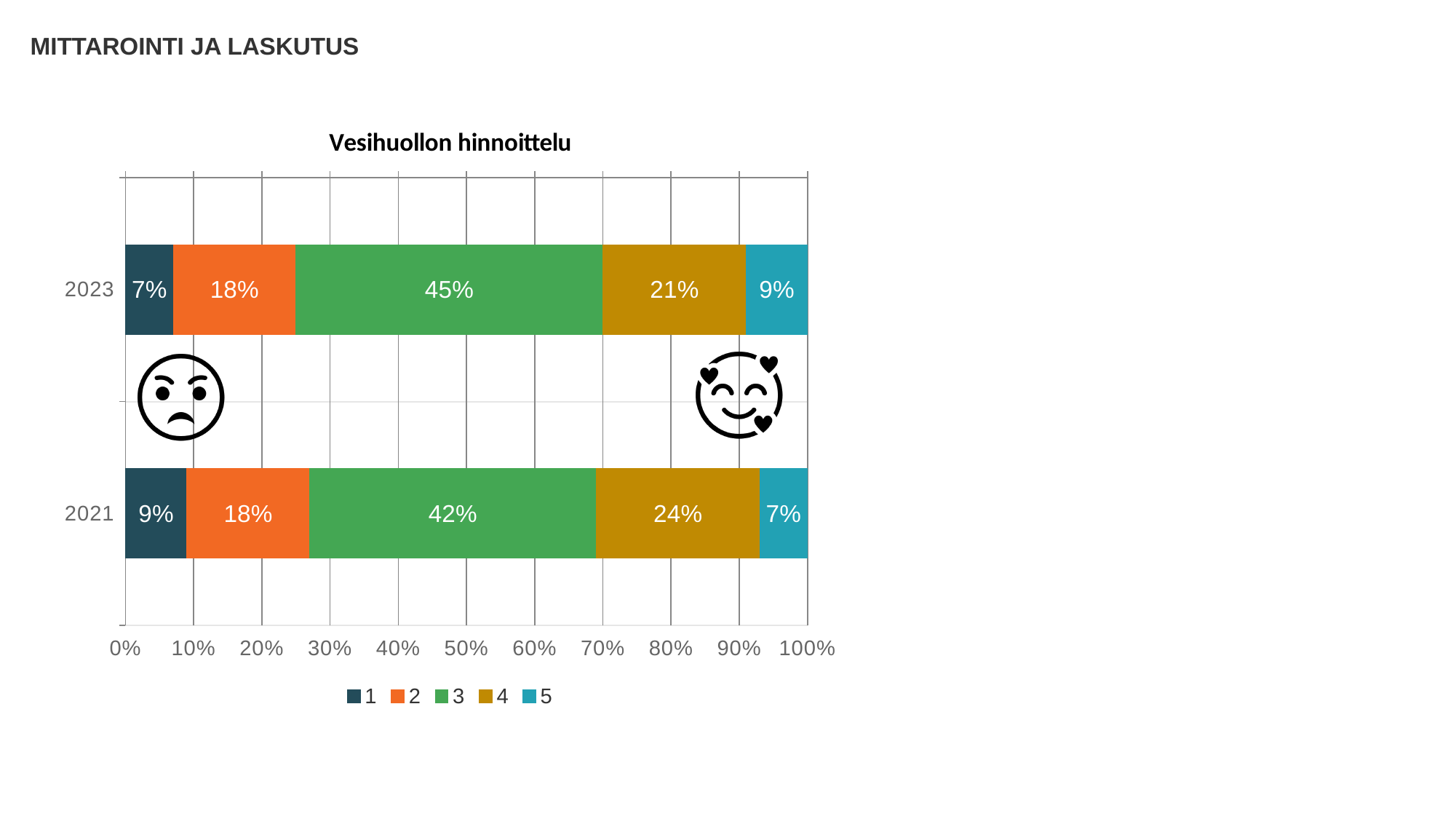
How many categories (years) are shown on the chart? 2 What is the value for series 3 in 2023? 45% What is the value for series 5 in 2021? 7% What is the value for series 1 in 2023? 7% Which series has the largest share in the 2021 bar? 3 What is the title of the chart? Vesihuollon hinnoittelu What kind of chart is shown on the slide? Stacked bar chart How many series does the legend list? 5 What is the difference between the series 3 values for 2023 and 2021? 3% Which series has the smallest share in the 2023 bar? 1 Which year has the larger value for series 4, 2023 or 2021? 2021 What is the value for series 4 in 2021? 24%